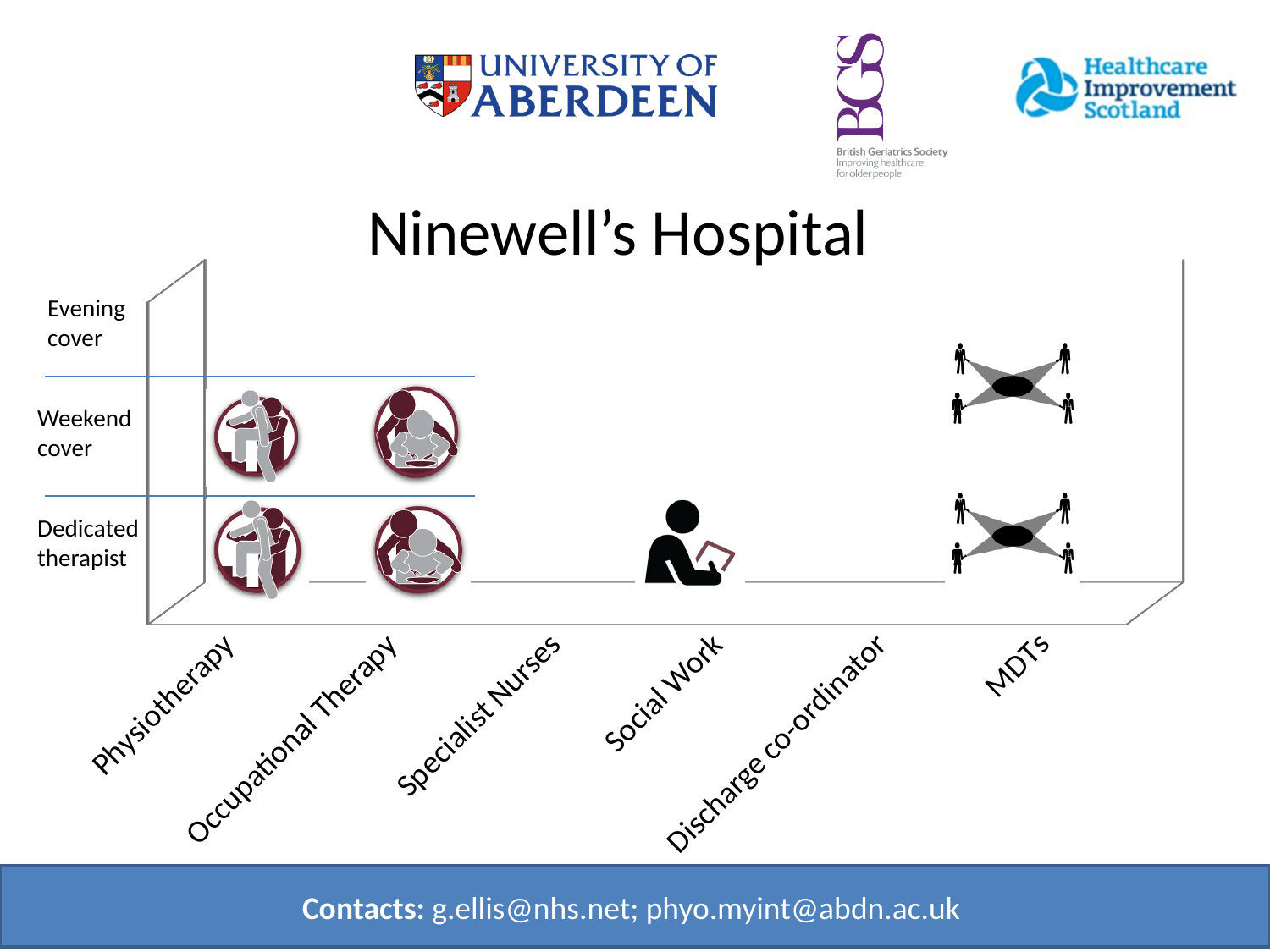
Does any category reach the Evening cover level? No What is the highest level of cover shown for Physiotherapy? Weekend cover How many categories reach the Weekend cover level? 3 How many levels are labelled on the vertical axis of the chart? 3 Which reaches a higher level of cover, Occupational Therapy or Social Work? Occupational Therapy What is the label of the lowest level on the vertical axis? Dedicated therapist What is the title of the chart? Ninewell's Hospital What is the label of the last category on the x axis? MDTs How many categories are shown along the x axis of the chart? 6 Which categories have no icons shown at any level? Specialist Nurses and Discharge co-ordinator What is the highest level of cover shown for MDTs? Weekend cover What is the highest level of cover shown for Social Work? Dedicated therapist